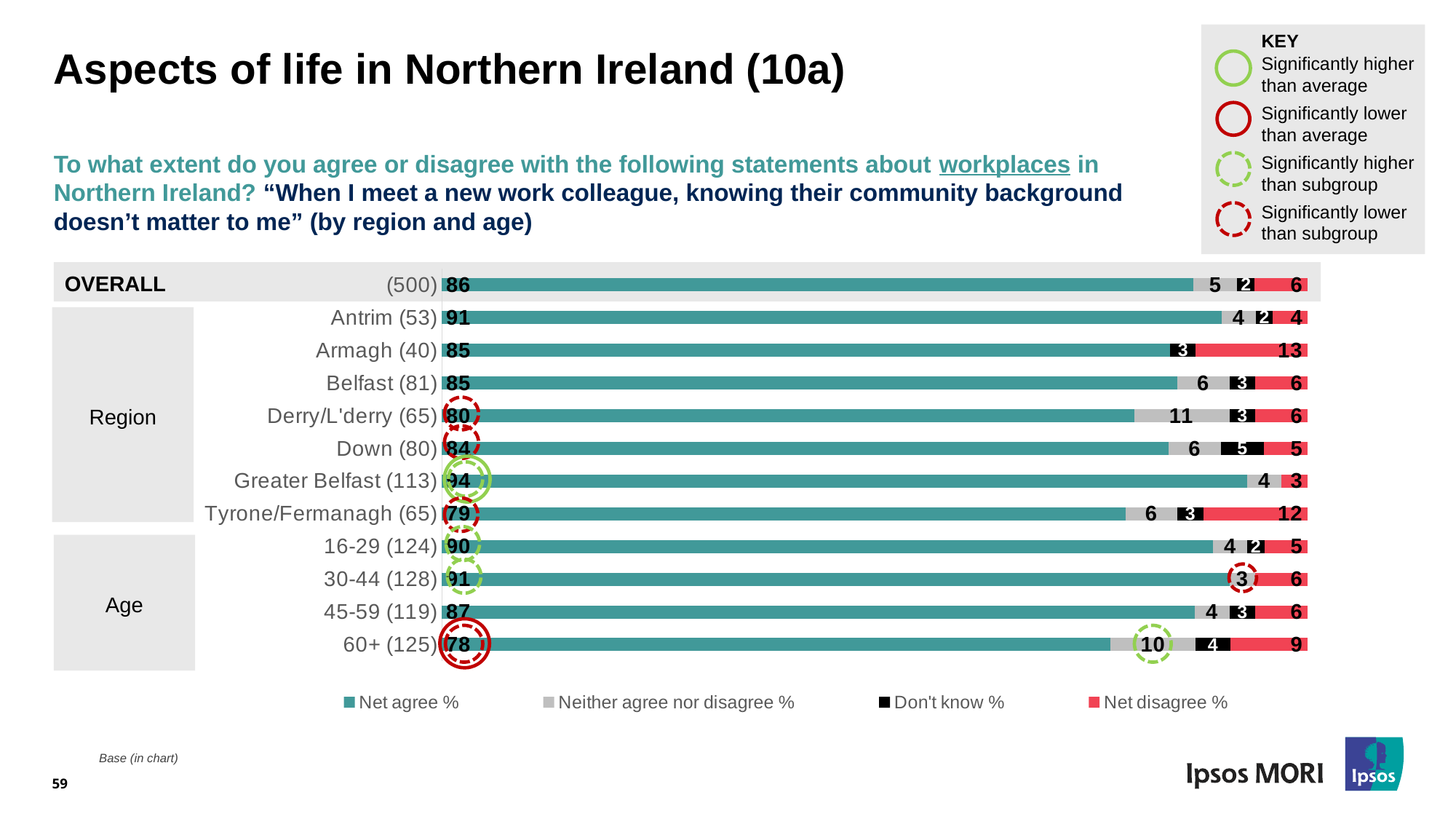
What is the Net disagree % for Armagh (40)? 13 What is the Net agree % for Greater Belfast (113)? 94 What is the difference in Net agree % between Greater Belfast (113) and 60+ (125)? 16 Which has a higher Net agree %, Antrim (53) or Tyrone/Fermanagh (65)? Antrim (53) Which category has the highest Net agree %? Greater Belfast (113) How many categories (rows) are plotted in the chart, including OVERALL? 12 How many series does the legend list? 4 What kind of chart is shown on the slide? Stacked bar chart Which category has the lowest Net agree %? 60+ (125) What is the Neither agree nor disagree % for Derry/L'derry (65)? 11 What is the Net agree % for the OVERALL (500) row? 86 Which category has the highest Net disagree %? Armagh (40)